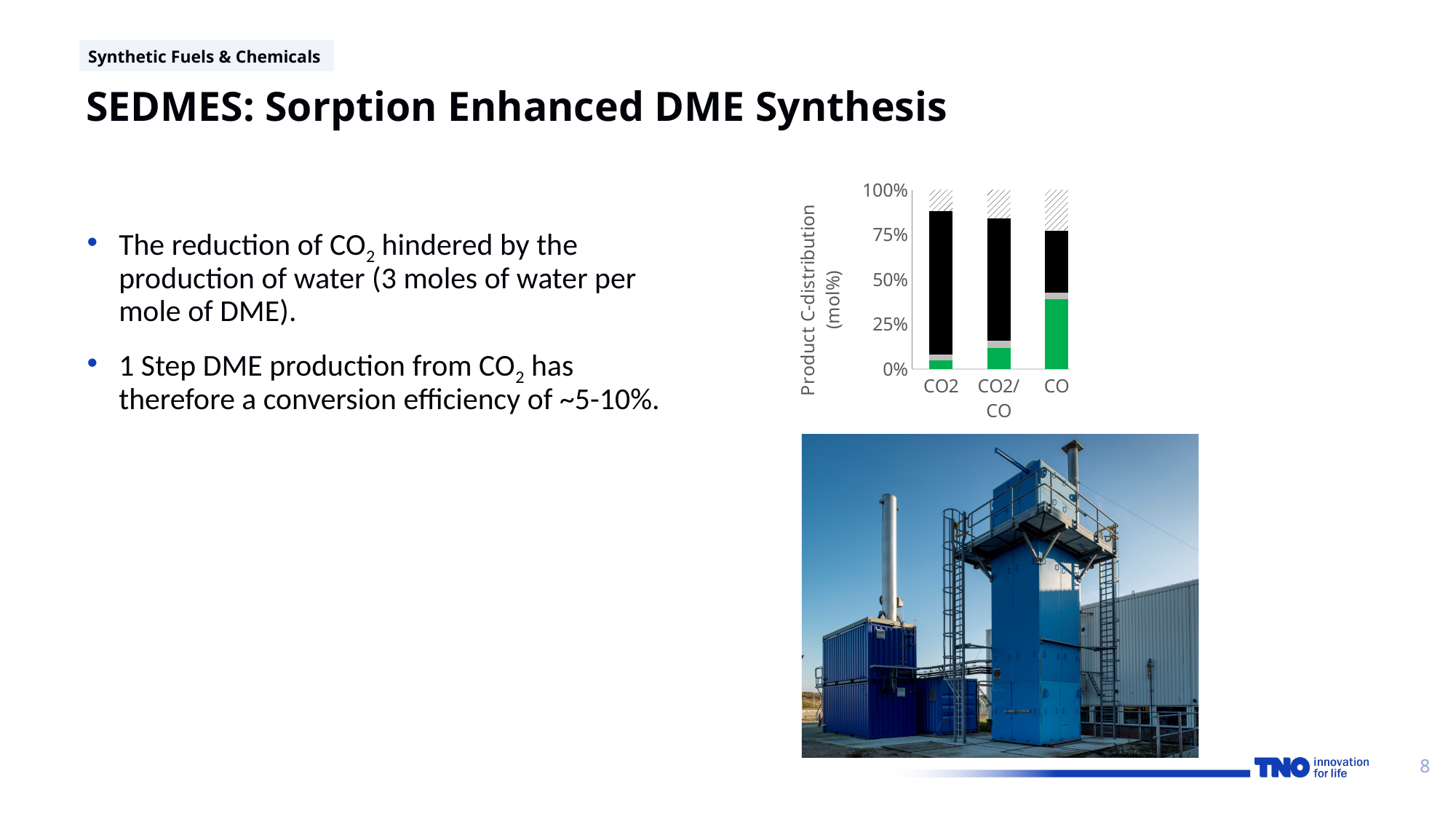
How many categories are shown on the x axis of the chart? 3 What kind of chart is shown on the slide? Stacked bar chart Is the green segment for CO greater or less than 25%? greater Which category has the largest green segment in the chart? CO What is the label of the y axis of the chart? Product C-distribution (mol%) Is the top of the black segment for CO2 greater or less than 75%? greater Is the green segment for CO2 greater or less than 25%? less Which category has the smallest green segment in the chart? CO2 Which has a larger black segment, CO2 or CO? CO2 Which has a larger green segment, CO2 or CO? CO What are the three categories on the x axis of the chart? CO2, CO2/CO, CO